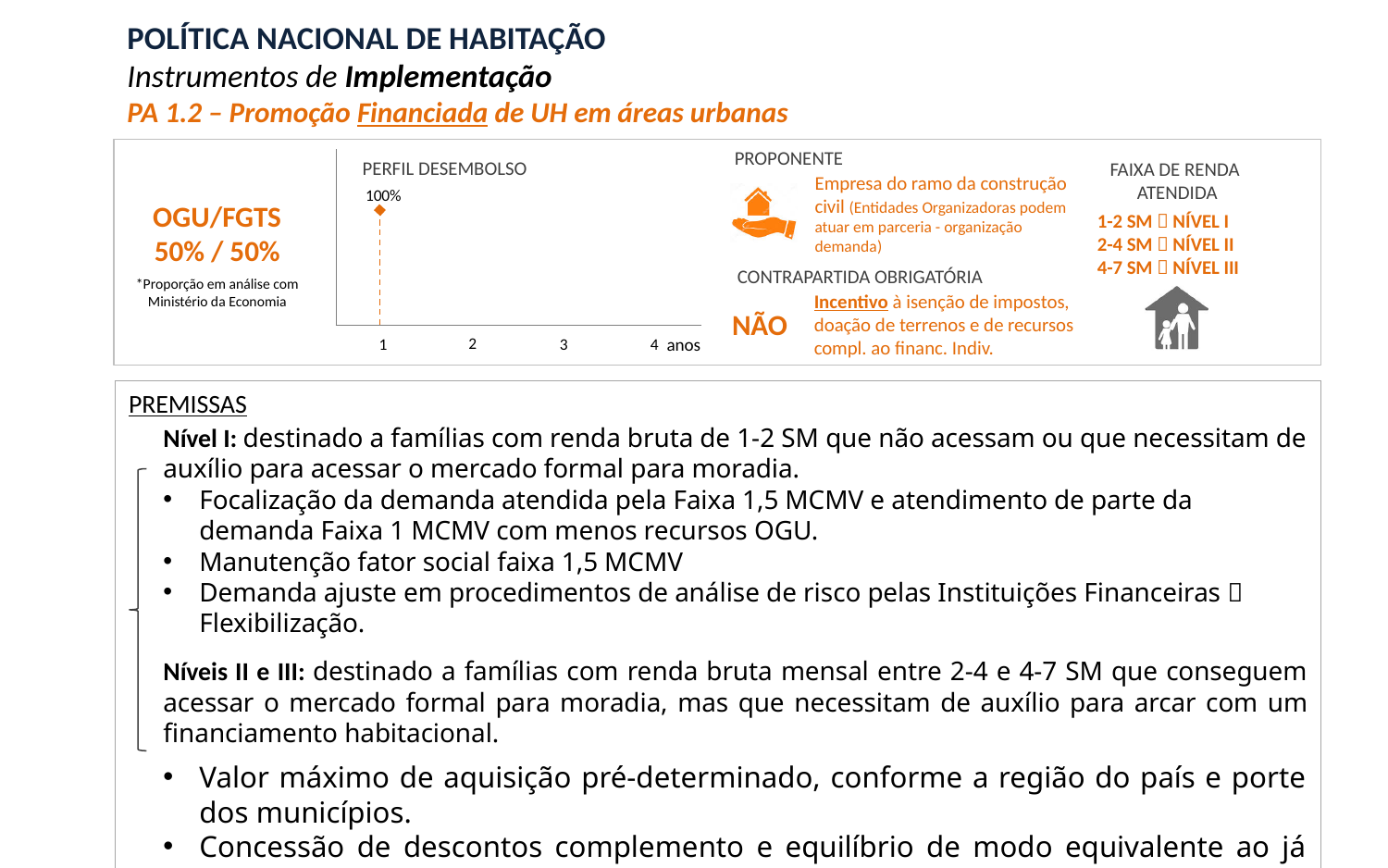
In the PERFIL DESEMBOLSO chart, at which year on the x axis is the 100% point plotted? 1 In the PERFIL DESEMBOLSO chart, what value is labelled on the plotted point at year 1? 100% How many data points are plotted in the PERFIL DESEMBOLSO chart? 1 How many year ticks are shown on the x axis of the PERFIL DESEMBOLSO chart? 4 What unit label appears at the end of the x axis of the PERFIL DESEMBOLSO chart? anos What is the title of the chart on the slide? PERFIL DESEMBOLSO